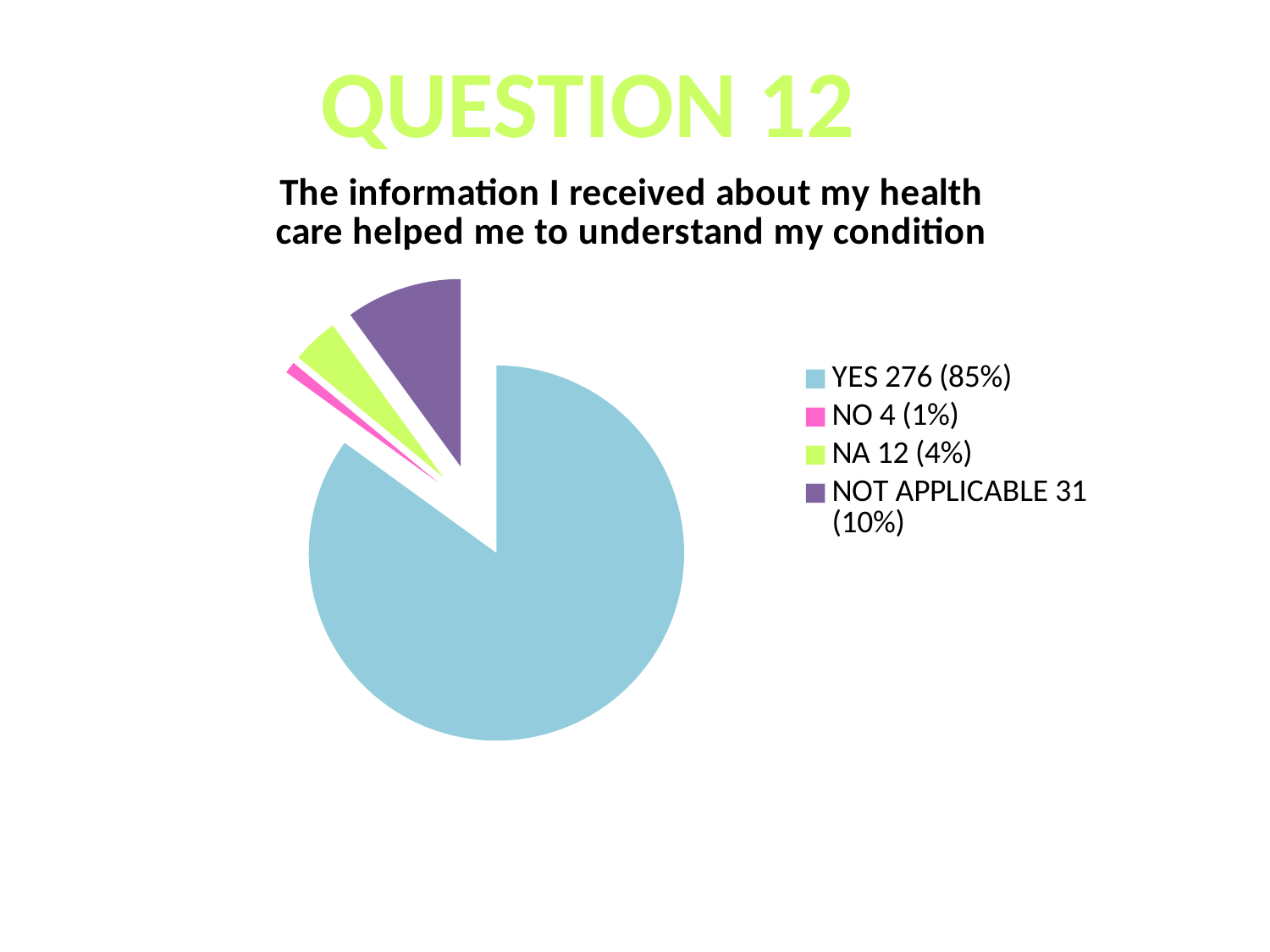
Which response has the smallest slice? NO What kind of chart is shown on the slide? pie chart How many respondents answered YES? 276 What is the title of the chart? The information I received about my health care helped me to understand my condition How many slices does the pie chart have? 4 How many entries does the legend list? 4 What is the difference between the number of YES and NOT APPLICABLE responses? 245 What percentage of responses were NOT APPLICABLE? 10% How many respondents answered NO? 4 Which response has the largest slice? YES What share of the pie is NA? 4% Which has more responses, NA or NOT APPLICABLE? NOT APPLICABLE